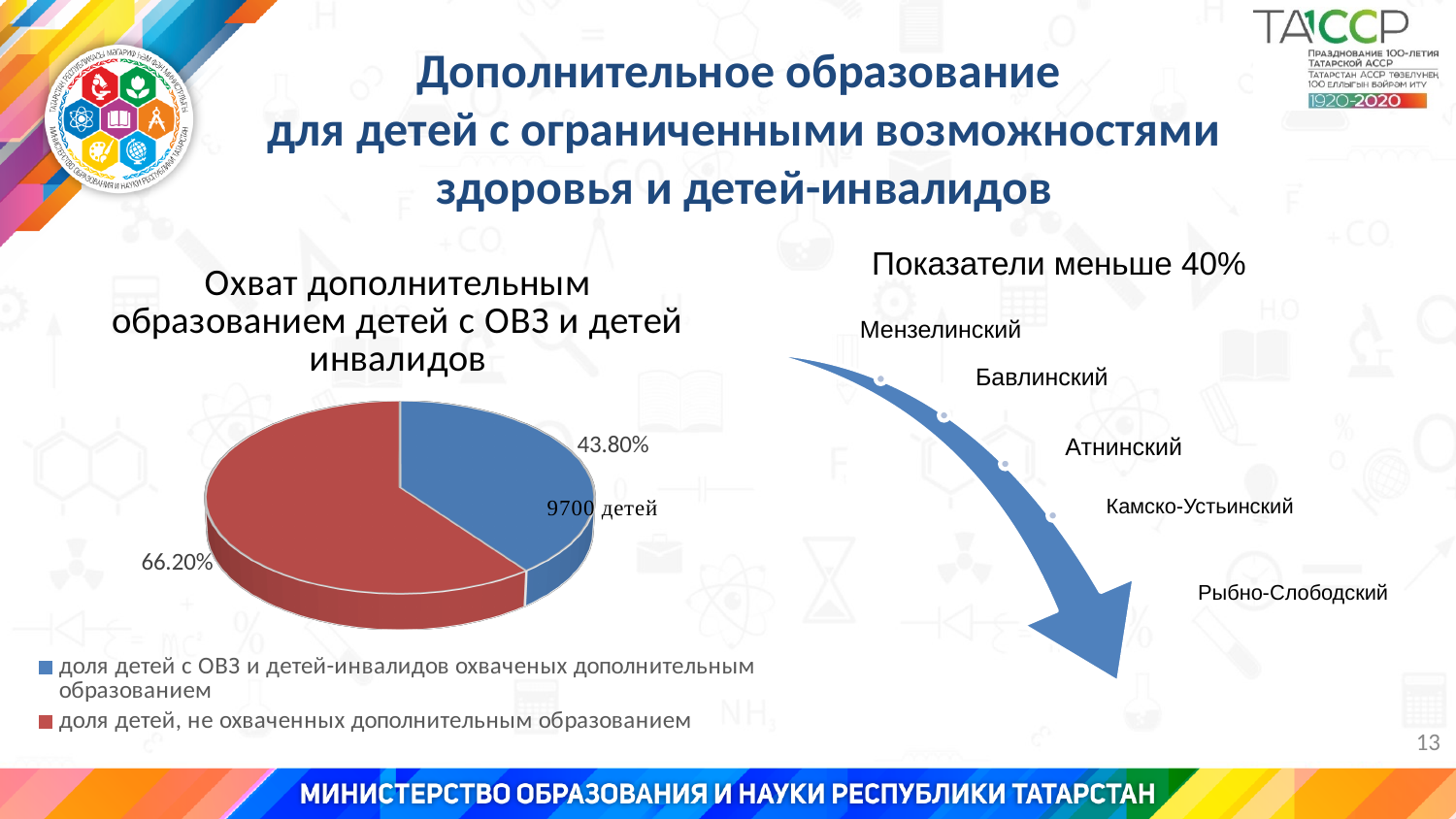
What number of children is labelled next to the blue slice of the pie chart? 9700 детей What colour is the slice for 'доля детей, не охваченных дополнительным образованием'? red How many slices does the pie chart have? 2 How many entries does the legend of the pie chart list? 2 What kind of chart is shown on the slide? pie chart Which slice of the pie chart is the smallest? доля детей с ОВЗ и детей-инвалидов охваченых дополнительным образованием Which is larger: the share of children covered by additional education or the share not covered? доля детей, не охваченных дополнительным образованием What percentage is shown for the slice 'доля детей с ОВЗ и детей-инвалидов охваченых дополнительным образованием'? 43.80% What is the difference between the two percentages shown on the pie chart? 22.40% What is the title of the pie chart? Охват дополнительным образованием детей с ОВЗ и детей инвалидов Which slice of the pie chart is the largest? доля детей, не охваченных дополнительным образованием What percentage is shown for the slice 'доля детей, не охваченных дополнительным образованием'? 66.20%